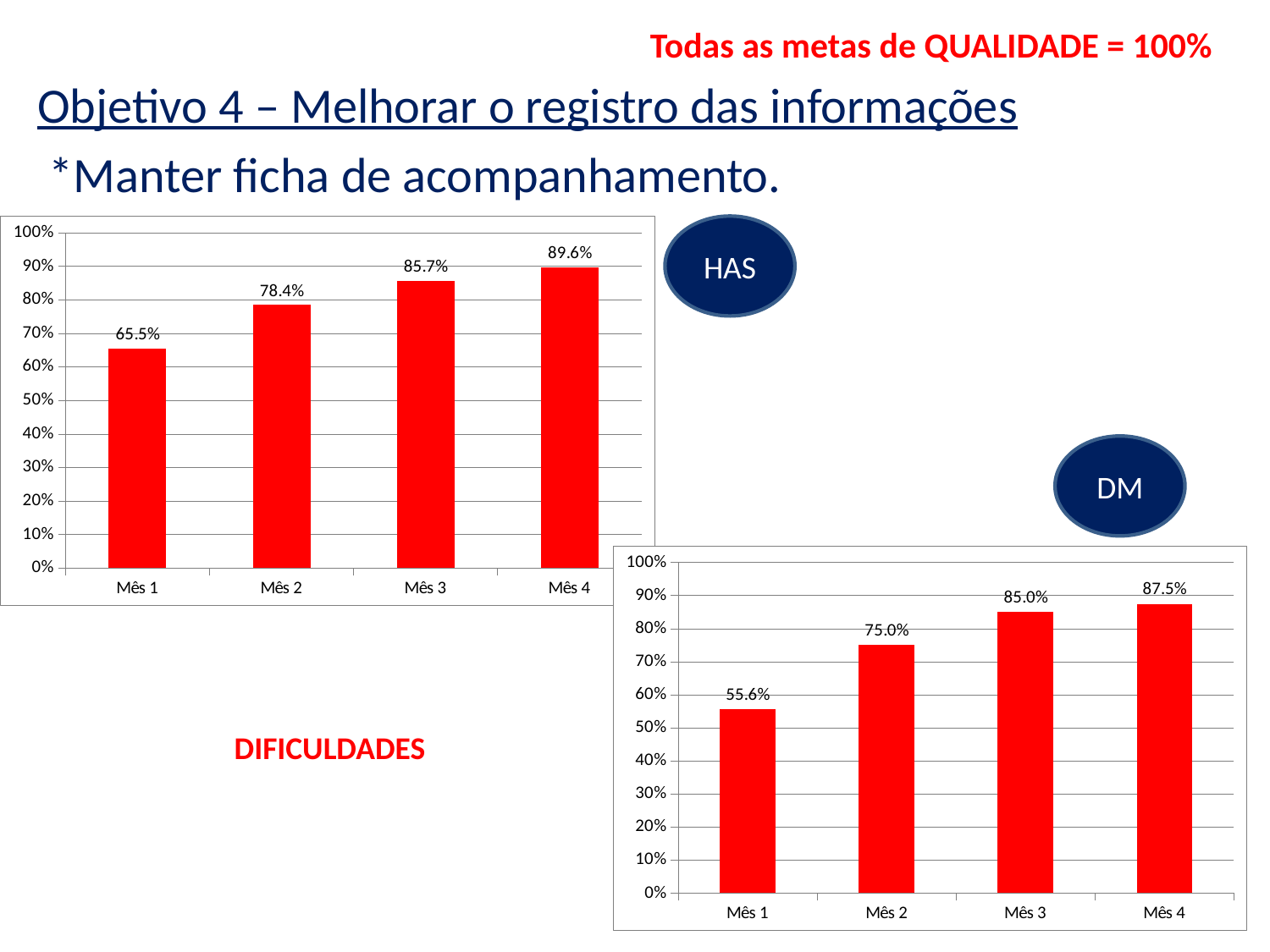
How many months are shown on the x axis of the lower-right chart? 4 What type of chart is the upper-left chart? Bar chart In the upper-left chart, what is the value for Mês 4? 89.6% Which is larger: the Mês 3 value in the upper-left chart or the Mês 3 value in the lower-right chart? The upper-left chart (85.7%) In the lower-right chart, which month has the highest value? Mês 4 In the upper-left chart, what is the value for Mês 2? 78.4% In the lower-right chart, what is the value for Mês 3? 85.0% In the lower-right chart, what is the value for Mês 1? 55.6% In the lower-right chart, what is the difference between the values for Mês 2 and Mês 1? 19.4% In the upper-left chart, which month has the lowest value? Mês 1 In the lower-right chart, do the values rise or fall from Mês 1 to Mês 4? Rise In the upper-left chart, what is the difference between the values for Mês 4 and Mês 1? 24.1%